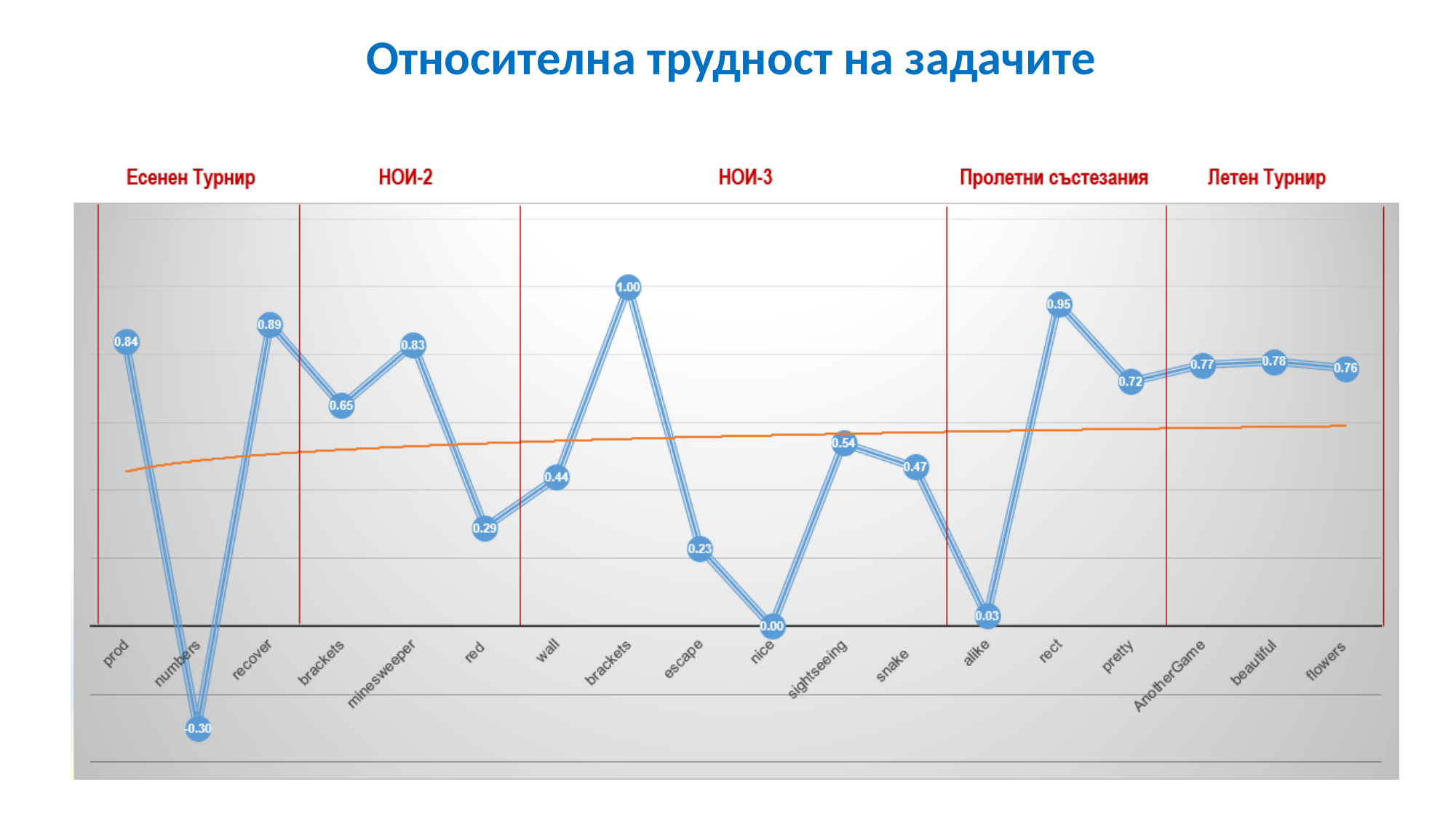
Which task has the lowest value? numbers What kind of chart is shown? line chart What is the value for rect? 0.95 How many tasks are plotted on the chart? 18 What is the value for prod? 0.84 Which task has the highest value? brackets (in НОИ-3), 1.00 What is the value for nice? 0.00 What is the difference between the values for rect and pretty? 0.23 Which is larger, the value for recover or the value for prod? recover What is the value for numbers? -0.30 How many competition sections are labelled above the chart? 5 What is the value for minesweeper? 0.83